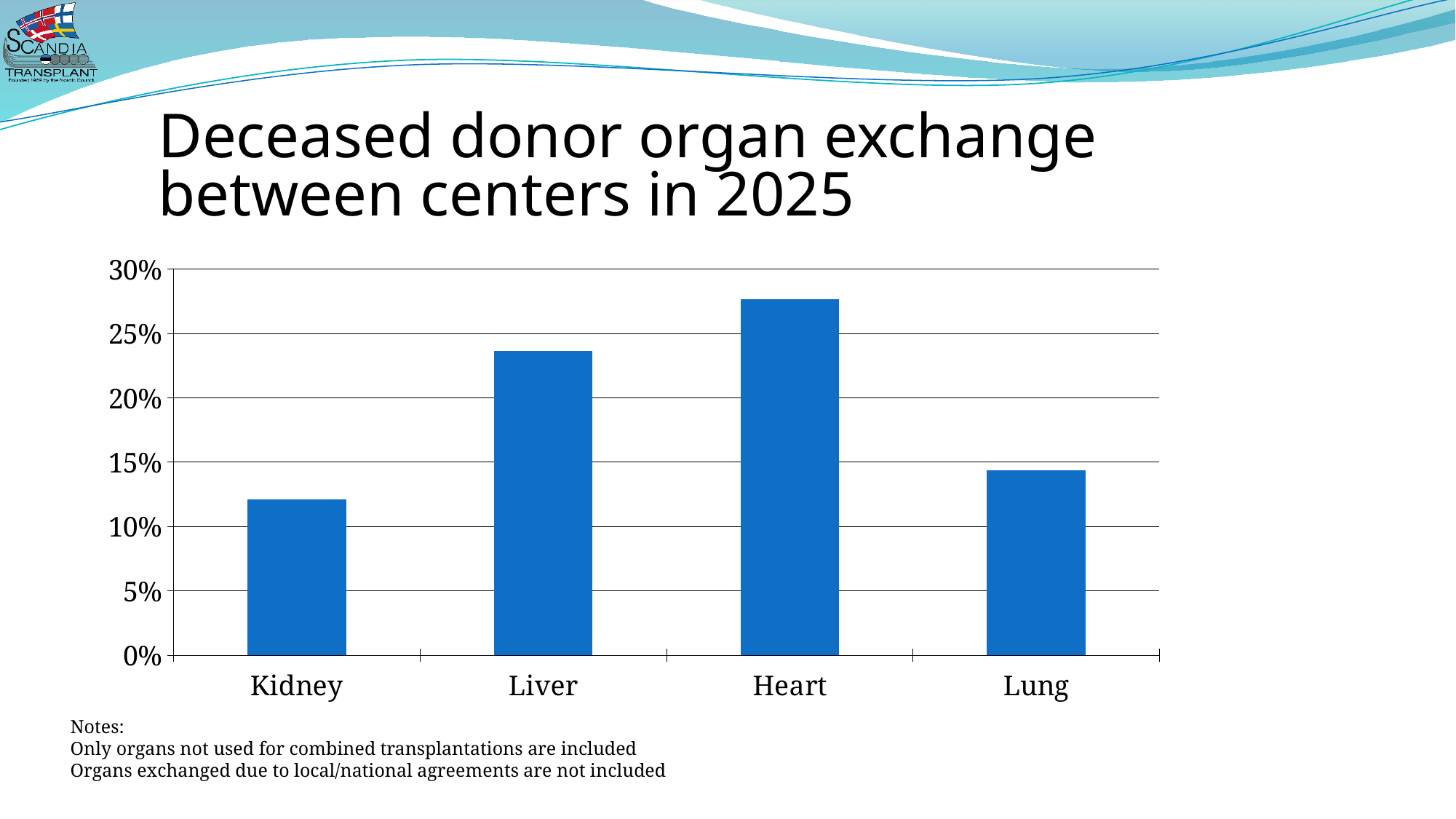
What kind of chart is shown on the slide? bar chart Is the value for Liver greater or less than 20%? greater How many organ categories are shown on the x axis? 4 Which is larger, the value for Liver or the value for Lung? Liver Which organ has the lowest exchange percentage? Kidney What is the title of the slide containing the chart? Deceased donor organ exchange between centers in 2025 Which is larger, the value for Kidney or the value for Heart? Heart Is the value for Kidney greater or less than 15%? less What is the highest value shown on the y axis? 30% Is the value for Heart greater or less than 25%? greater Which organ has the highest exchange percentage? Heart